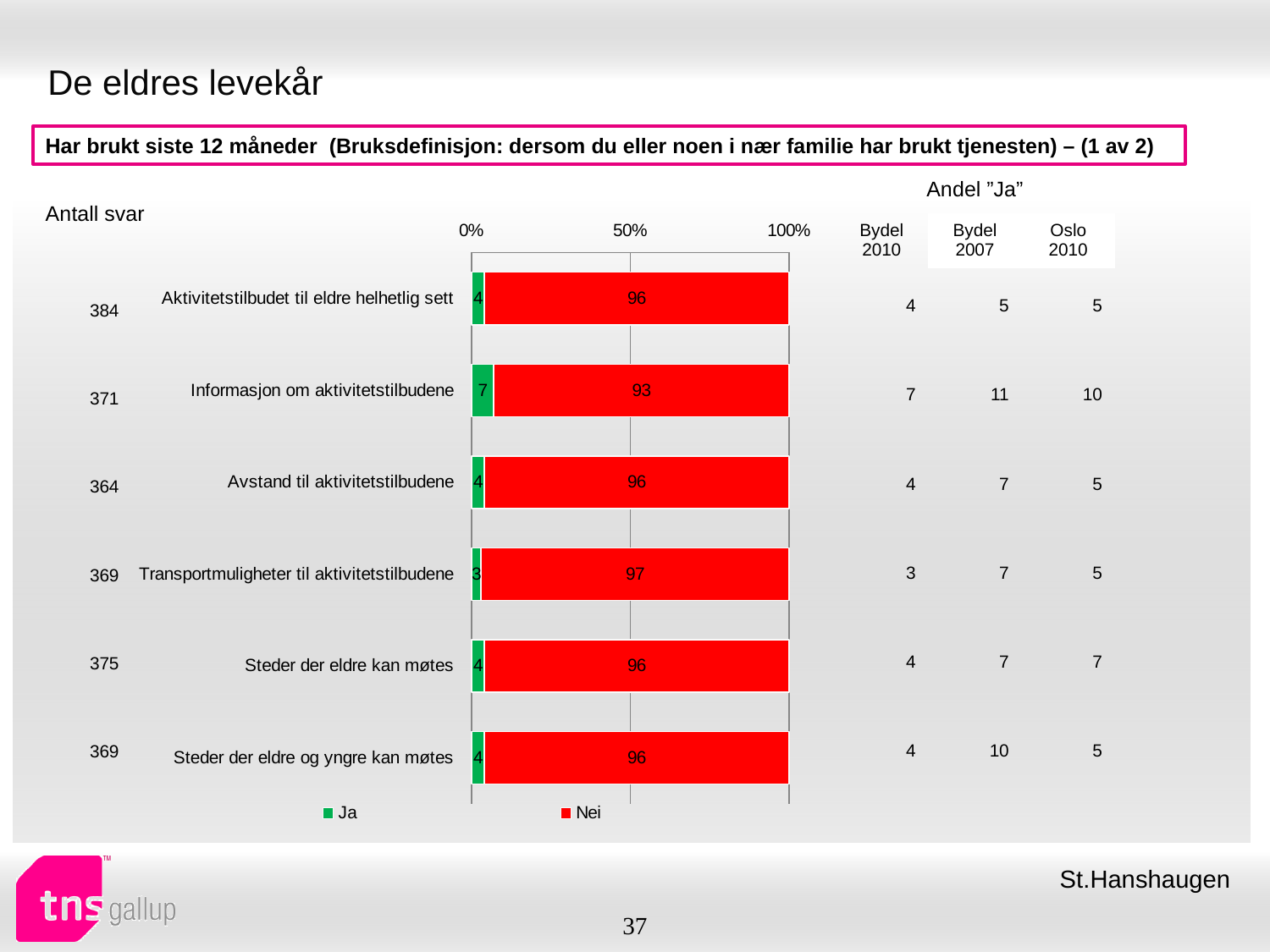
Which category has the lowest 'Ja' value? Transportmuligheter til aktivitetstilbudene Is the 'Nei' value for 'Aktivitetstilbudet til eldre helhetlig sett' greater or less than 50%? greater How many categories are plotted in the chart? 6 Which is larger: the 'Ja' value for 'Informasjon om aktivitetstilbudene' or the 'Ja' value for 'Steder der eldre kan møtes'? Informasjon om aktivitetstilbudene What kind of chart is shown on the slide? stacked bar chart What is the 'Ja' value for 'Transportmuligheter til aktivitetstilbudene'? 3 What is the 'Nei' value for 'Transportmuligheter til aktivitetstilbudene'? 97 What is the difference between the 'Nei' values for 'Transportmuligheter til aktivitetstilbudene' and 'Informasjon om aktivitetstilbudene'? 4 What are the two series named in the chart legend? Ja and Nei Which category has the highest 'Ja' value? Informasjon om aktivitetstilbudene What is the 'Nei' value for 'Informasjon om aktivitetstilbudene'? 93 How many series does the chart legend list? 2